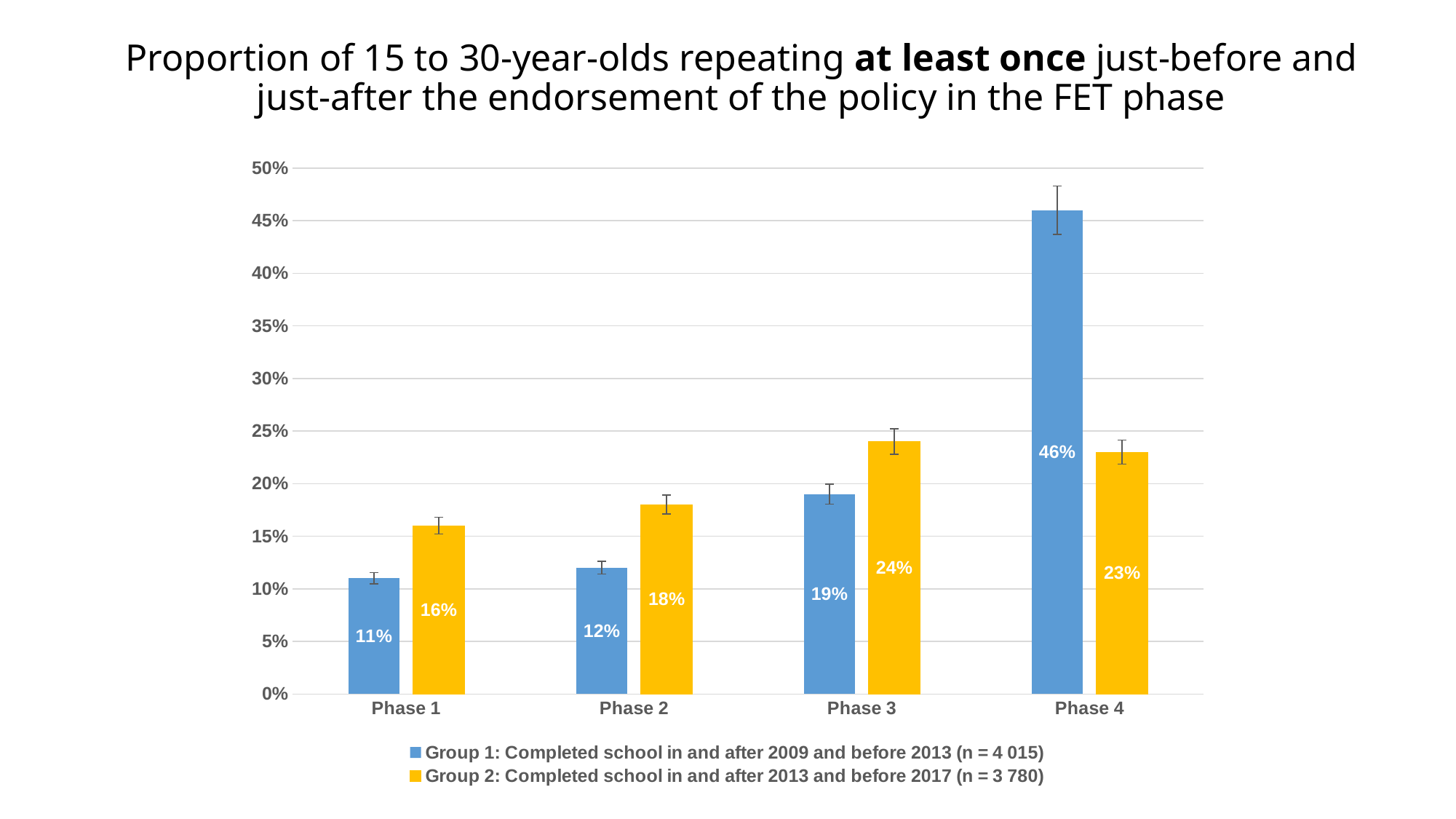
What is the value for Group 1 in Phase 4? 46% How many phases are shown on the x axis? 4 What kind of chart is shown? Bar chart What is the value for Group 2 in Phase 1? 16% Do the Group 2 values rise or fall from Phase 1 to Phase 3? Rise What is the difference between Group 1 and Group 2 in Phase 4? 23% Which is larger in Phase 3, Group 1 or Group 2? Group 2 In which phase is the Group 2 value lowest? Phase 1 How many series does the legend list? 2 In which phase is the Group 1 value highest? Phase 4 What is the value for Group 1 in Phase 2? 12% What is the value for Group 2 in Phase 3? 24%